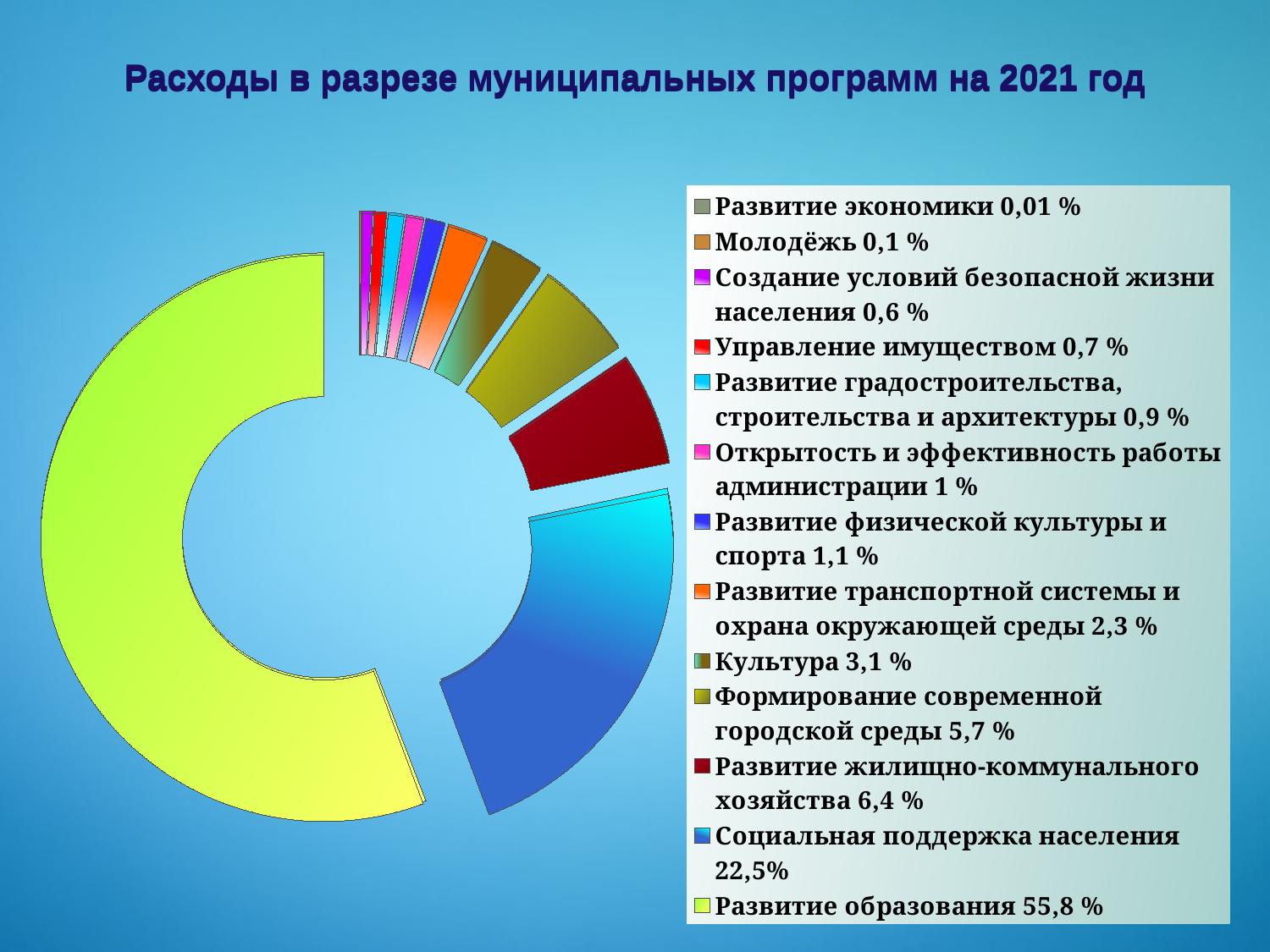
What is the title of the chart? Расходы в разрезе муниципальных программ на 2021 год What percentage is shown for «Социальная поддержка населения»? 22,5% What is the difference in percentage points between «Развитие образования» and «Социальная поддержка населения»? 33,3 What kind of chart is shown on the slide? Doughnut (pie) chart What share of expenditure does the legend give for «Развитие образования»? 55,8 % Which programme has the smallest share of expenditure? Развитие экономики What percentage is listed for «Молодёжь»? 0,1 % Which programme has the largest share of expenditure? Развитие образования How many programmes are listed in the legend? 13 What percentage is shown for «Развитие транспортной системы и охрана окружающей среды»? 2,3 % Which has a larger share: «Развитие жилищно-коммунального хозяйства» or «Формирование современной городской среды»? Развитие жилищно-коммунального хозяйства What percentage is listed for «Культура»? 3,1 %